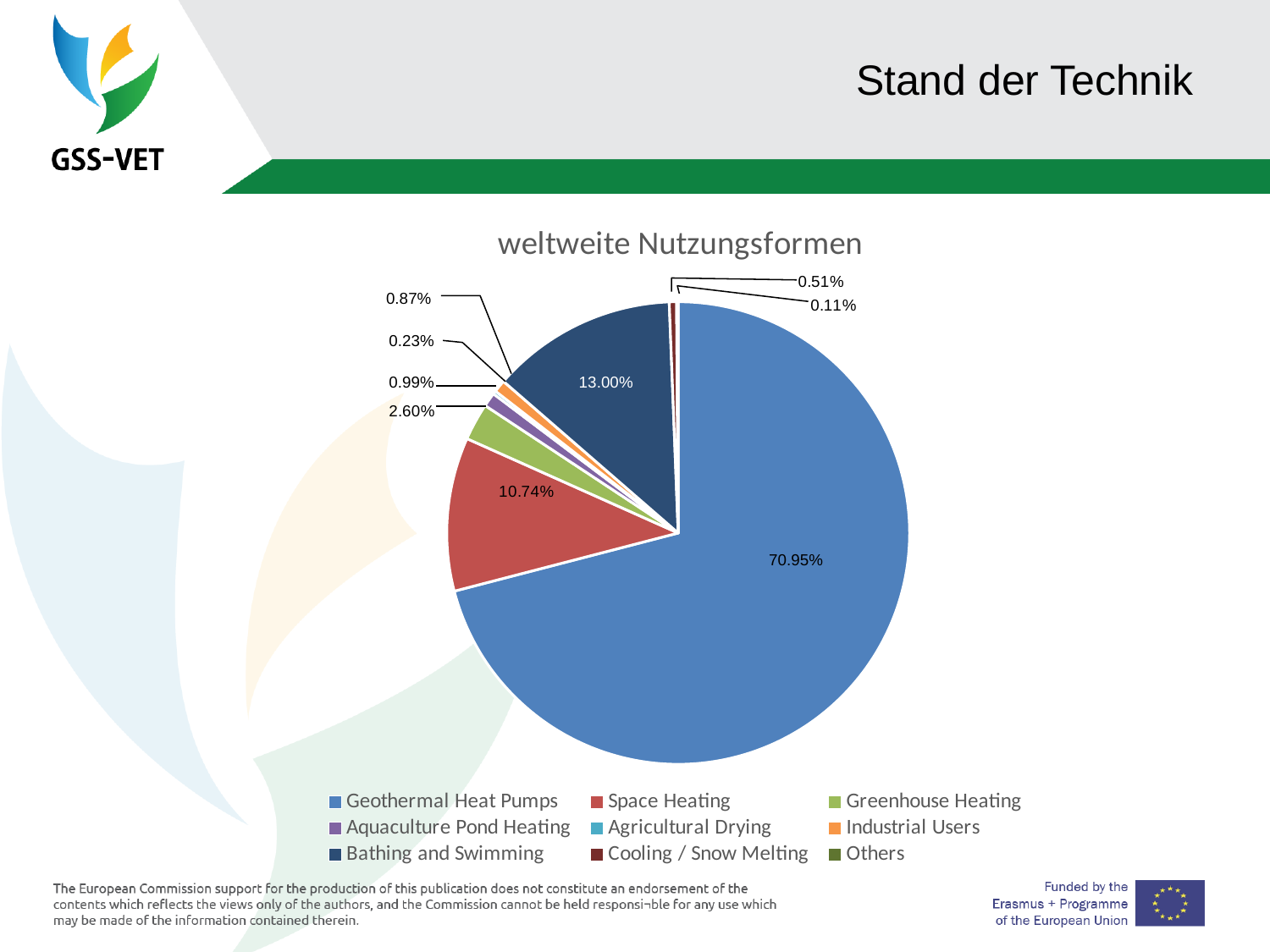
What type of chart is shown on the slide? pie chart What share of the pie does Geothermal Heat Pumps have? 70.95% Which category has the largest slice of the pie? Geothermal Heat Pumps What colour is the slice for Geothermal Heat Pumps? blue Which is larger, the slice for Space Heating or the slice for Bathing and Swimming? Bathing and Swimming What share of the pie does Bathing and Swimming have? 13.00% What is the difference between the shares of Geothermal Heat Pumps and Space Heating? 60.21% What share of the pie does Greenhouse Heating have? 2.60% How many categories does the legend of the pie chart list? 9 What is the title of the chart? weltweite Nutzungsformen